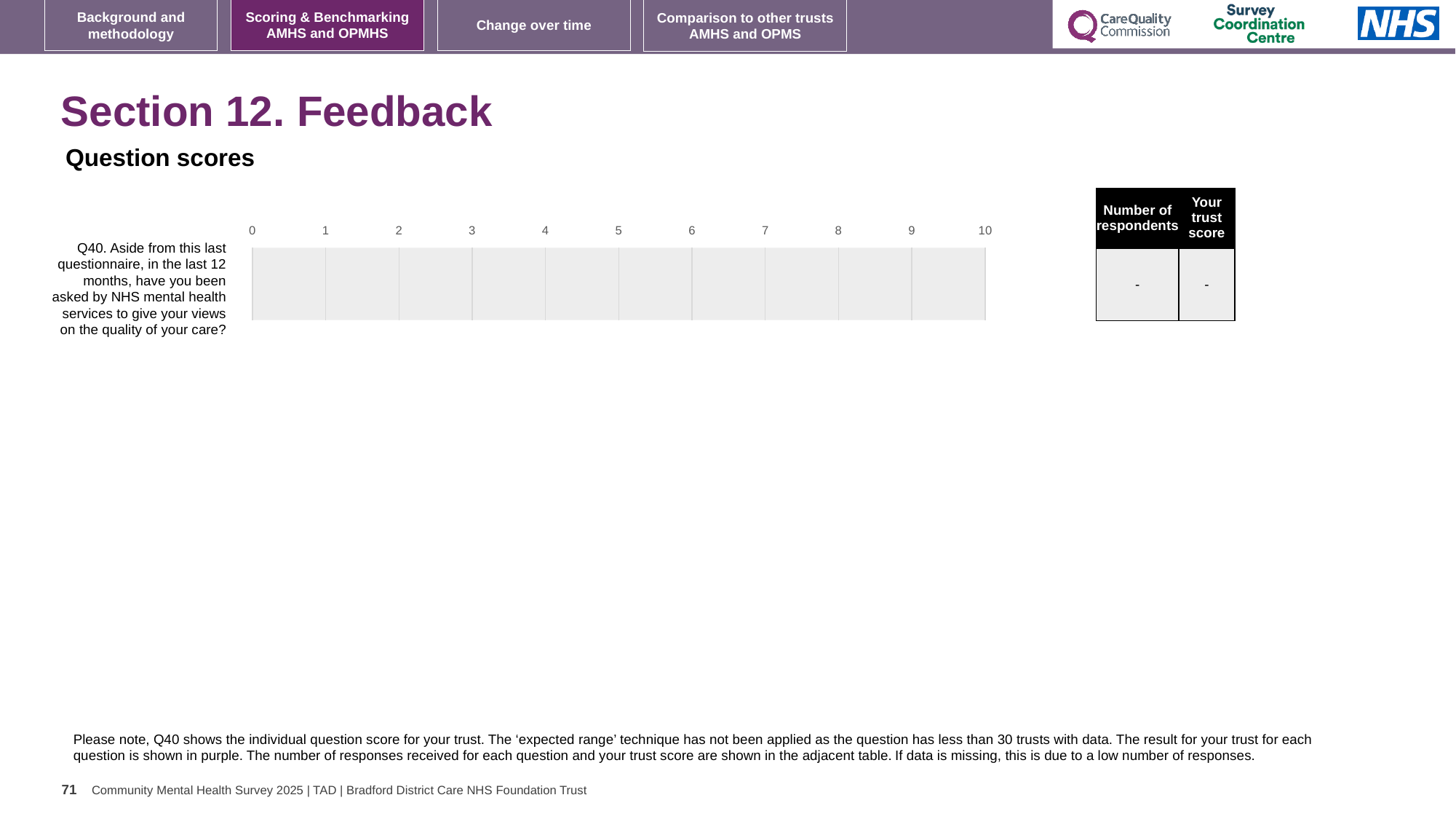
What is shown in the 'Your trust score' column of the table for Q40? - Is a bar plotted for Q40 on the chart? No What is shown in the 'Number of respondents' column of the table for Q40? - What is the highest value shown on the chart's horizontal axis? 10 What kind of chart is shown on the slide? bar chart How many question categories are listed on the chart's vertical axis? 1